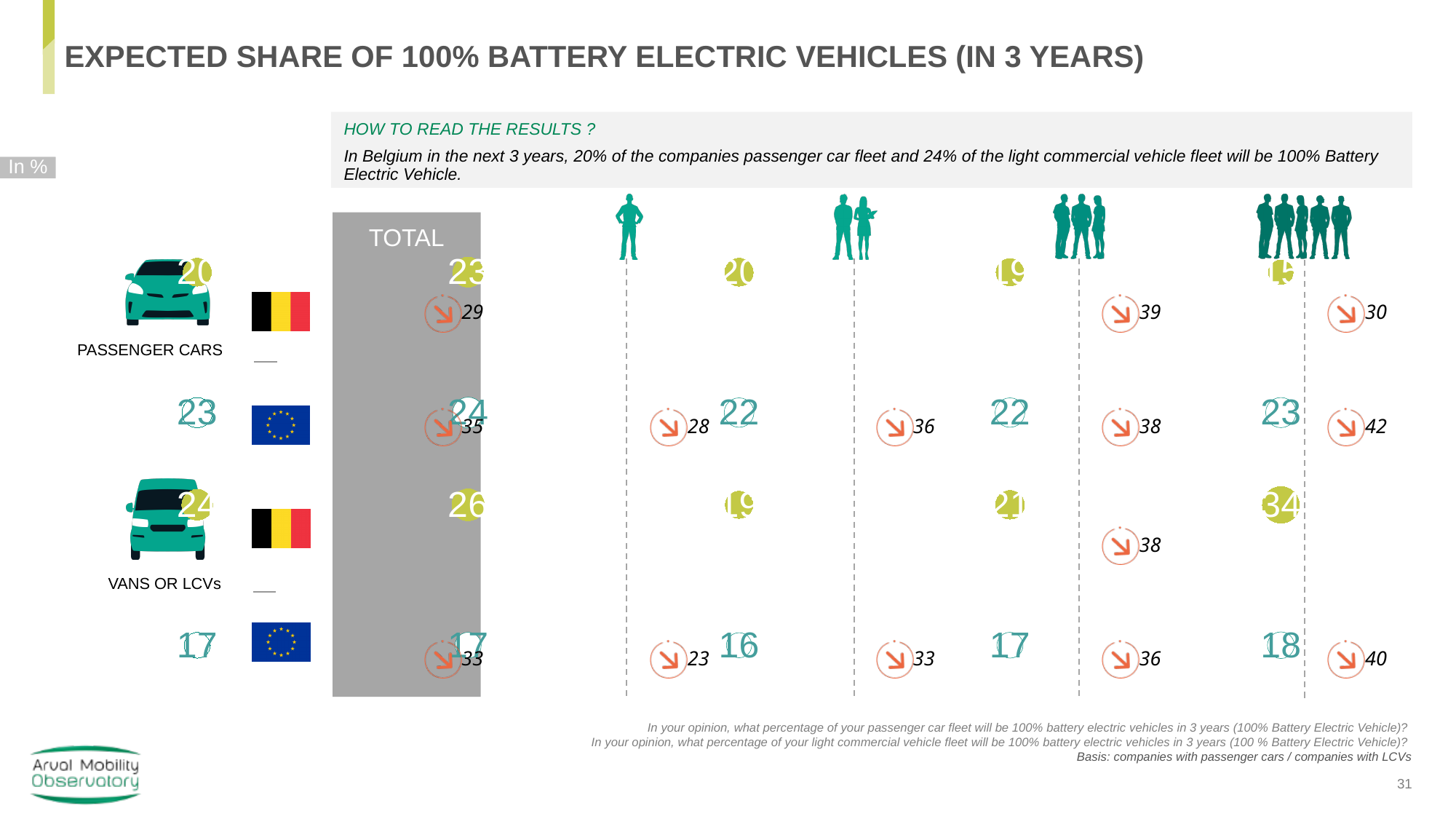
What is the TOTAL expected share of 100% battery electric vehicles for passenger cars in Belgium? 23 In what unit are the values on this chart expressed? In % What expected share is shown next to the EU flag for passenger cars? 23 What is the TOTAL expected share of 100% battery electric vehicles for vans or LCVs in Belgium? 26 Which is larger for Belgium: the expected share for passenger cars or for vans or LCVs? Vans or LCVs What expected share is shown next to the Belgian flag for passenger cars? 20 What is the difference between the Europe and Belgium expected shares for passenger cars (23 vs 20)? 3 What is the TOTAL expected share of 100% battery electric vehicles for vans or LCVs in Europe (EU flag row)? 17 What is the TOTAL expected share of 100% battery electric vehicles for passenger cars in Europe (EU flag row)? 24 What is the difference between the TOTAL value for vans or LCVs in Belgium and the TOTAL value for passenger cars in Belgium? 3 What expected share is shown next to the Belgian flag for vans or LCVs? 24 What is the highest value shown in the vans or LCVs Belgium row across the company-size columns? 34